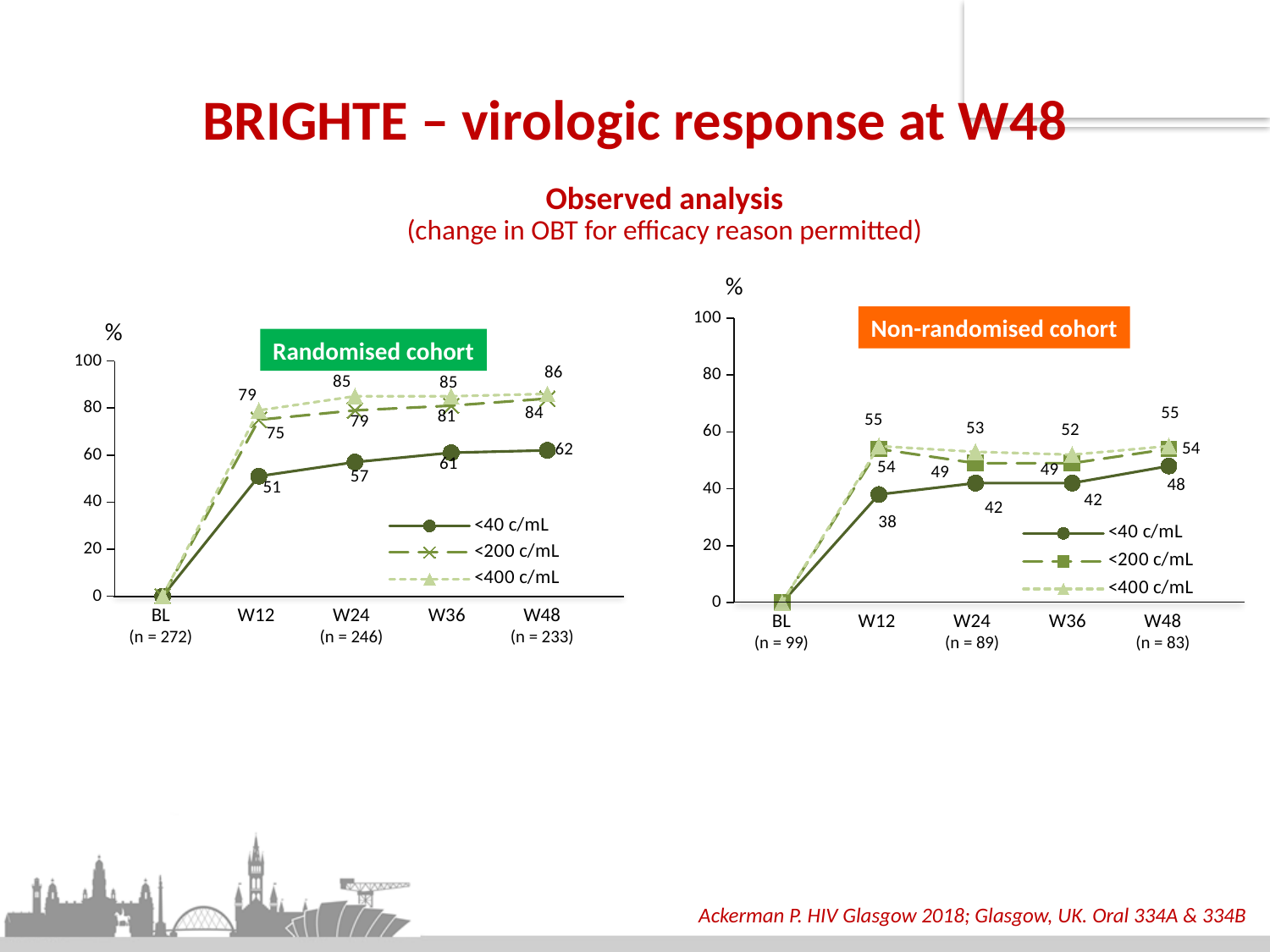
In the Non-randomised cohort chart, what is the value for <40 c/mL at W12? 38 In the Randomised cohort chart, what is the value for <400 c/mL at W24? 85 What kind of chart is the Randomised cohort chart? line chart In the Randomised cohort chart, what is the difference between the <400 c/mL and <40 c/mL values at W48? 24 In the Randomised cohort chart, what is the value for <40 c/mL at W48? 62 How many time points are shown on the x axis of the Randomised cohort chart? 5 In the Non-randomised cohort chart, what is the difference between the <400 c/mL value at W12 and the <40 c/mL value at W12? 17 In the Non-randomised cohort chart, what is the value for <200 c/mL at W48? 54 In the Randomised cohort chart, does the <40 c/mL series rise or fall from W12 to W48? rise How many series does the legend of the Non-randomised cohort chart list? 3 In the Non-randomised cohort chart, at which time point is the <40 c/mL value highest? W48 In the Randomised cohort chart, which is larger at W12: the <200 c/mL value or the <40 c/mL value? <200 c/mL